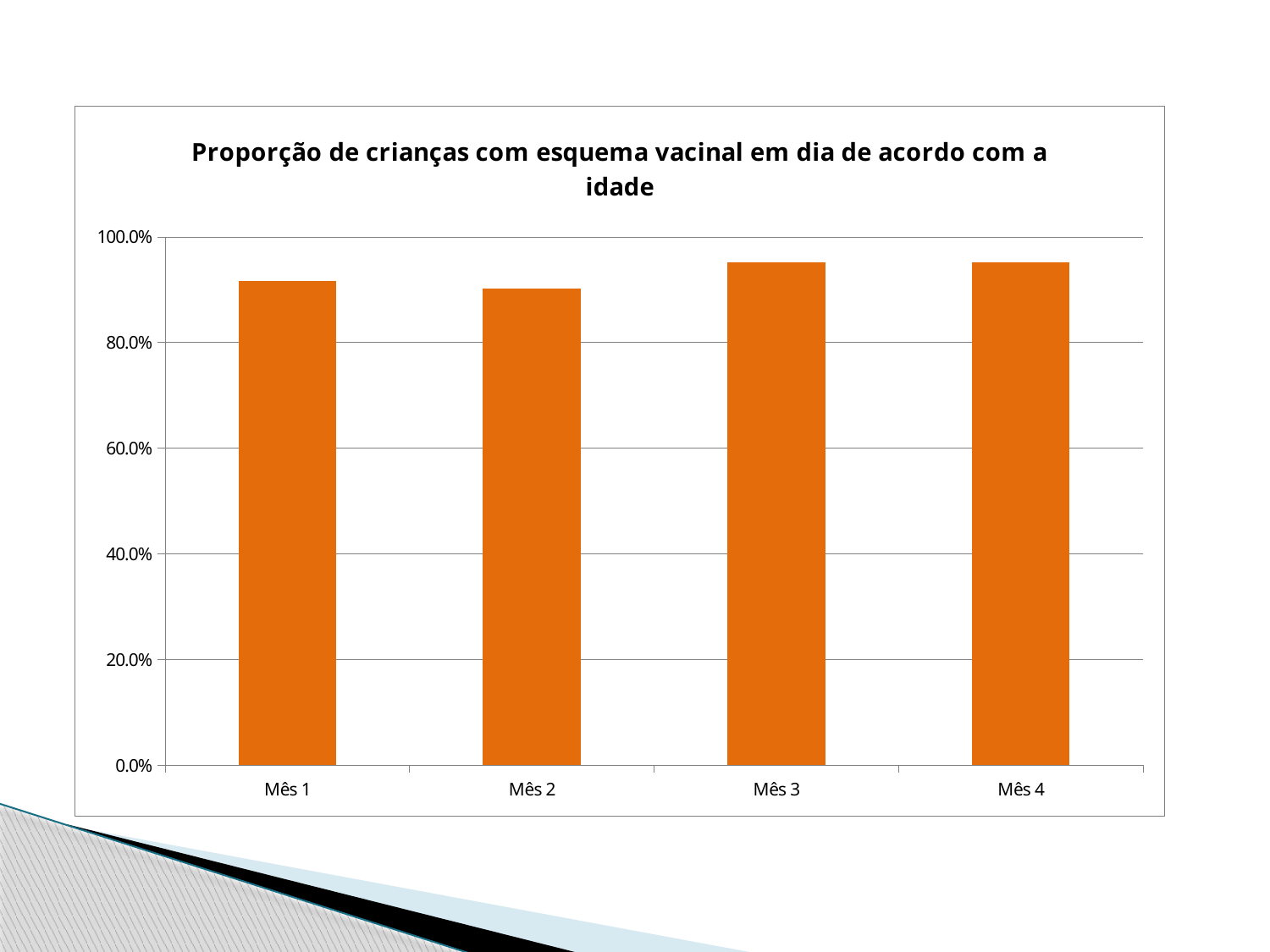
Is the value for Mês 4 greater or less than 80.0%? greater How many categories are plotted on the x axis? 4 Is the value for Mês 1 greater or less than 80.0%? greater Is the value for Mês 3 greater or less than 100.0%? less What colour are the bars in the chart? orange What kind of chart is shown on the slide? bar chart Which is larger, the value for Mês 4 or the value for Mês 2? Mês 4 What is the label of the first category on the x axis? Mês 1 Which is larger, the value for Mês 3 or the value for Mês 2? Mês 3 What is the title of the chart? Proporção de crianças com esquema vacinal em dia de acordo com a idade Which is larger, the value for Mês 3 or the value for Mês 1? Mês 3